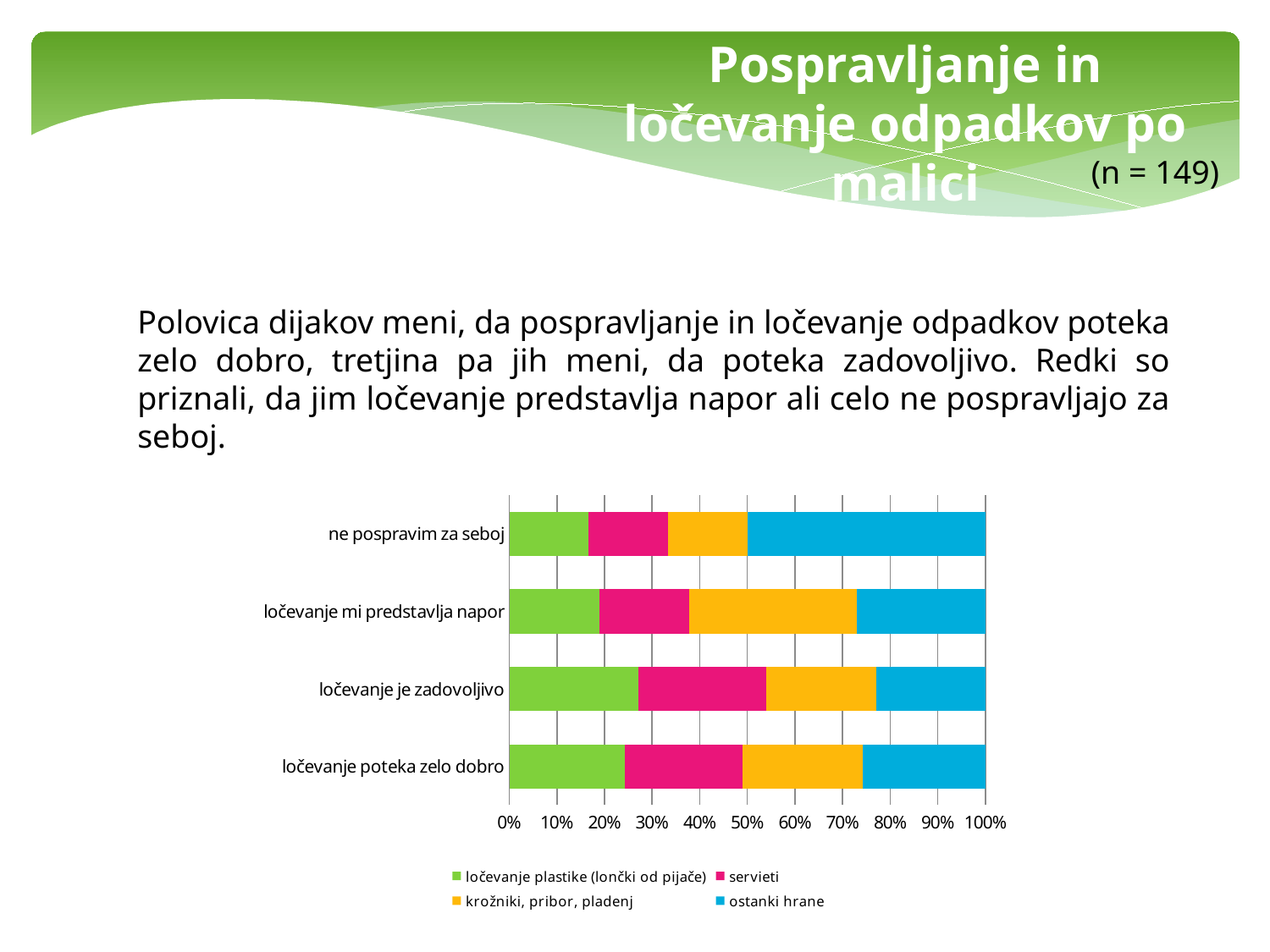
Which series is shown in green in the chart? ločevanje plastike (lončki od pijače) Is the 'ostanki hrane' segment for 'ne pospravim za seboj' greater or less than 40%? greater Is the 'ločevanje plastike (lončki od pijače)' segment for 'ne pospravim za seboj' greater or less than 20%? less Which series is shown in blue in the chart? ostanki hrane Which category has the largest 'ostanki hrane' segment? ne pospravim za seboj Is the 'ločevanje plastike (lončki od pijače)' segment larger for 'ločevanje je zadovoljivo' or for 'ne pospravim za seboj'? ločevanje je zadovoljivo Which category has the largest 'krožniki, pribor, pladenj' segment? ločevanje mi predstavlja napor What value does each stacked bar in the chart reach on the horizontal axis? 100% Is the 'krožniki, pribor, pladenj' segment for 'ločevanje mi predstavlja napor' greater or less than 30%? greater How many series does the chart legend list? 4 What kind of chart is shown on the slide? stacked bar chart How many categories are plotted on the vertical axis of the chart? 4